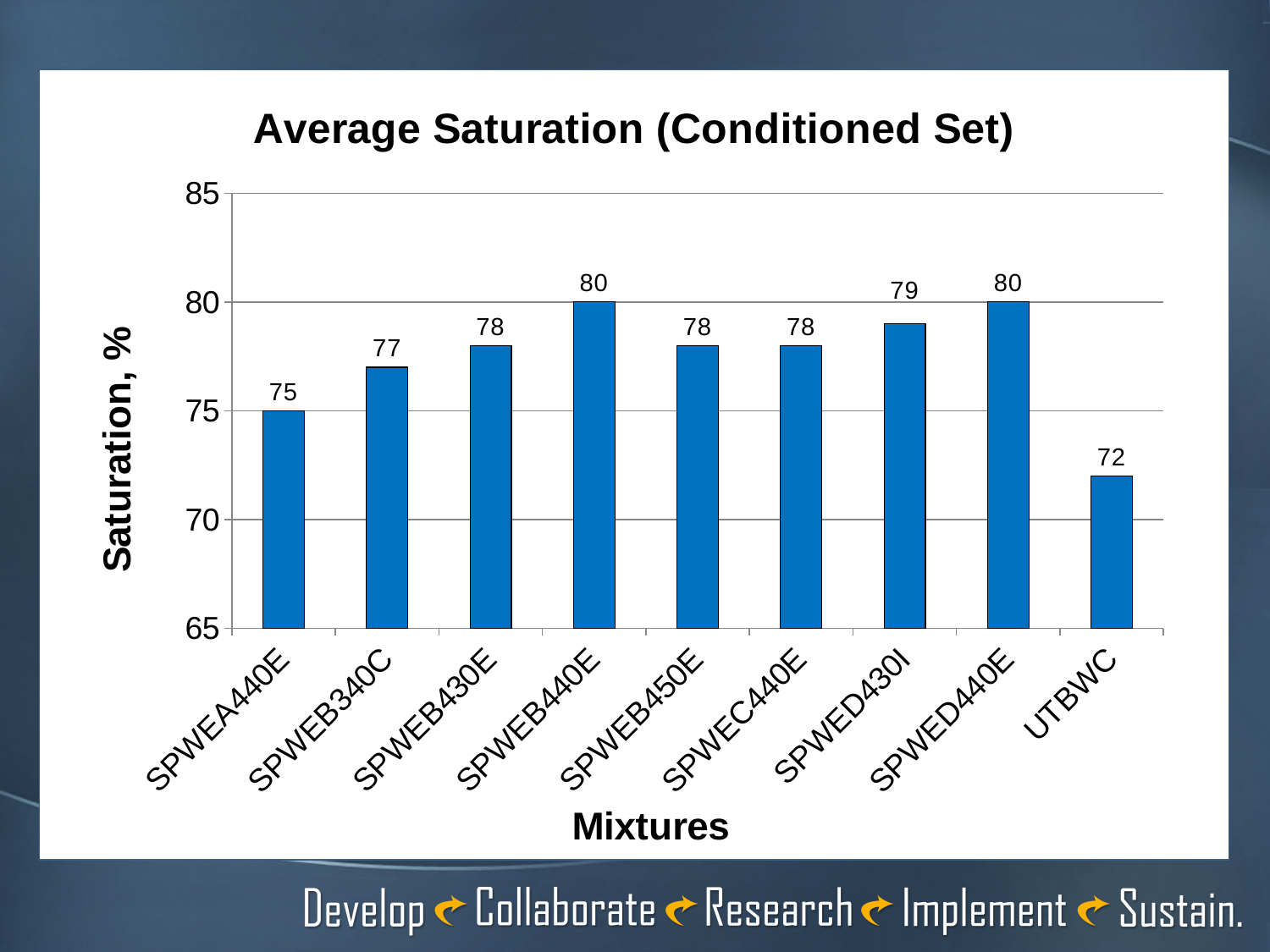
What is the average saturation for SPWEA440E? 75 What is the average saturation for SPWEB340C? 77 What is the title of the chart? Average Saturation (Conditioned Set) What type of chart is shown on the slide? Bar chart What is the difference in average saturation between SPWEB440E and UTBWC? 8 What is the difference in average saturation between SPWED430I and SPWEA440E? 4 Which mixture has the lowest average saturation? UTBWC How many mixtures are shown on the chart? 9 What is the average saturation for UTBWC? 72 What is the highest average saturation value shown on the chart? 80 Which has a higher average saturation, SPWEB340C or SPWEB430E? SPWEB430E What is the average saturation for SPWED430I? 79